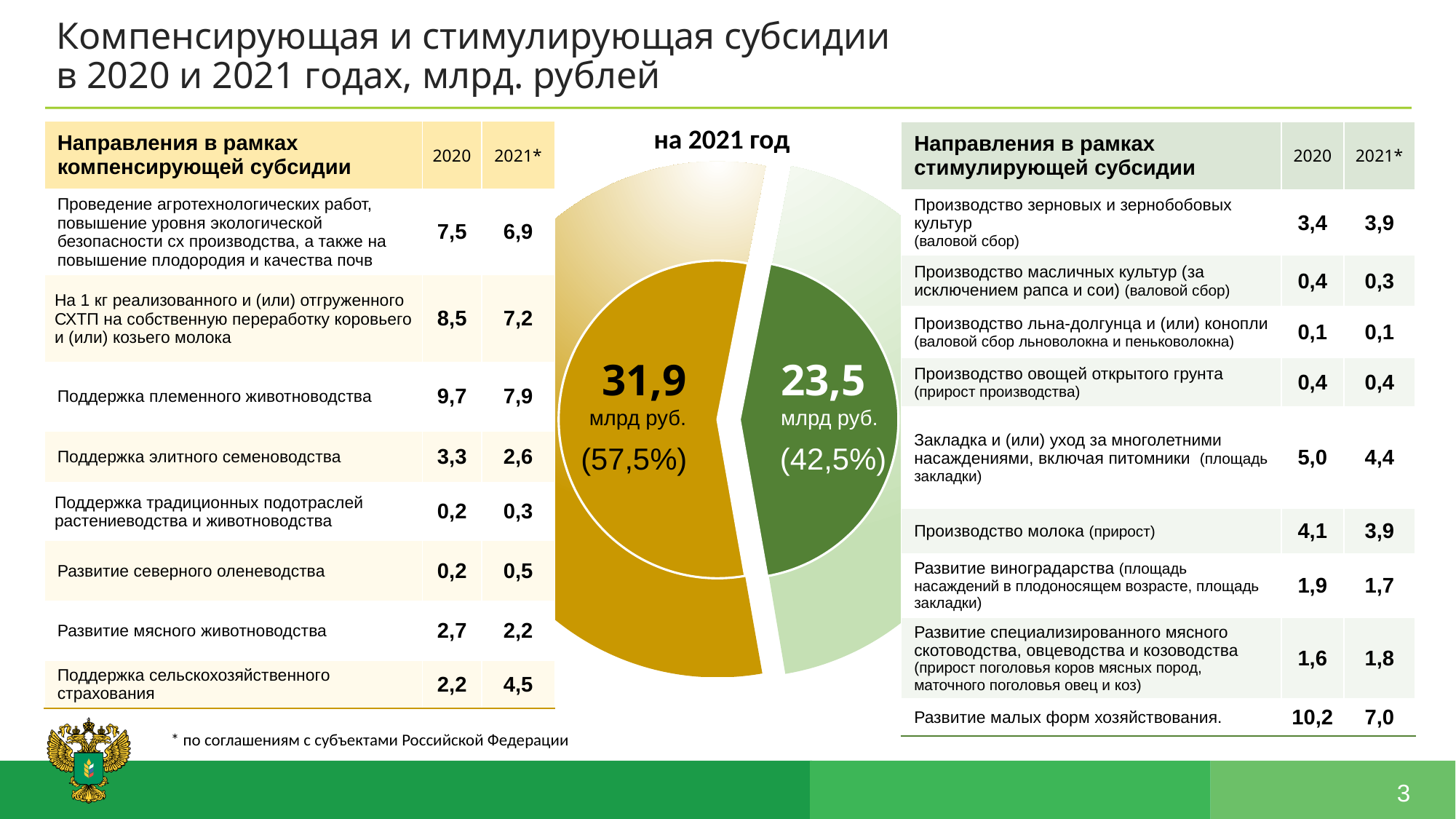
In the pie chart "на 2021 год", what is the total in млрд руб. of the two slices (31,9 and 23,5)? 55,4 What heading is printed above the pie chart in the centre of the slide? на 2021 год In the pie chart "на 2021 год", which slice is larger, the gold one or the green one? the gold one In the pie chart "на 2021 год", what percentage share is printed on the green slice? 42,5% What unit is printed under the numbers inside the pie chart slices? млрд руб. In the pie chart "на 2021 год", what is the difference in млрд руб. between the gold slice (31,9) and the green slice (23,5)? 8,4 In the pie chart "на 2021 год", what value in млрд руб. is printed on the gold (yellow) slice? 31,9 Is the value on the gold slice of the pie chart "на 2021 год" greater or less than 30 млрд руб.? greater In the pie chart "на 2021 год", what value in млрд руб. is printed on the green slice? 23,5 How many slices does the pie chart "на 2021 год" have? 2 In the pie chart "на 2021 год", what percentage share is printed on the gold slice? 57,5% What kind of chart is shown in the centre of the slide under the heading "на 2021 год"? pie chart